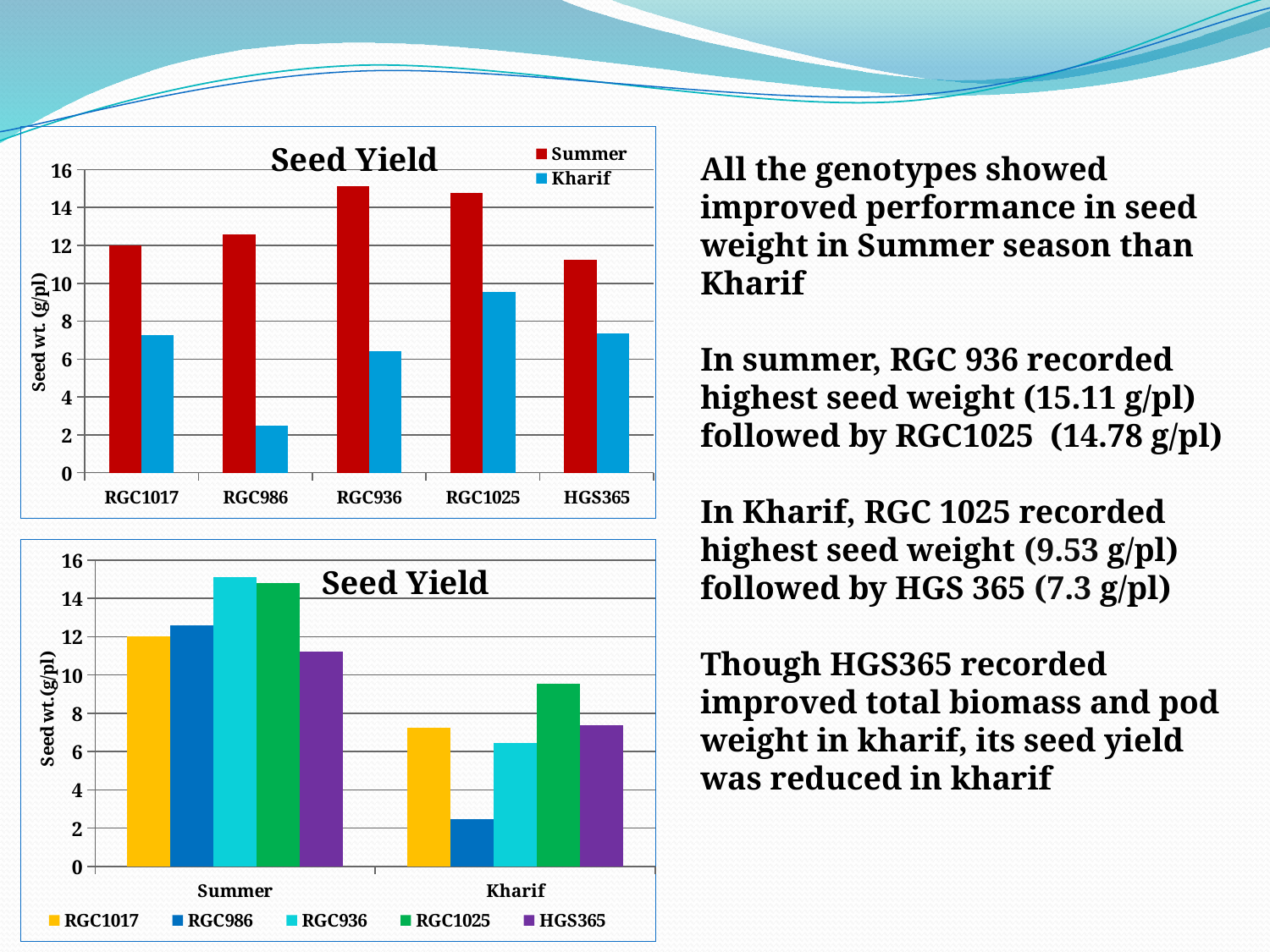
In the top chart, is the Summer value for RGC936 greater or less than 14? greater In the top chart, which is larger for RGC986: the Summer value or the Kharif value? Summer In the top chart, which genotype has the highest Kharif seed yield? RGC1025 How many genotypes are shown on the x axis of the top chart? 5 What is the y-axis label of the top chart? Seed wt. (g/pl) In the top chart, which genotype has the lowest Kharif seed yield? RGC986 In the top chart, which genotype has the highest Summer seed yield? RGC936 In the bottom chart, is the Kharif value for RGC1025 greater or less than 10? less What kind of chart is the bottom chart? Bar chart In the top chart, which genotype has the lowest Summer seed yield? HGS365 In the top chart, is the Kharif value for RGC986 greater or less than 4? less How many series does the legend of the bottom chart list? 5